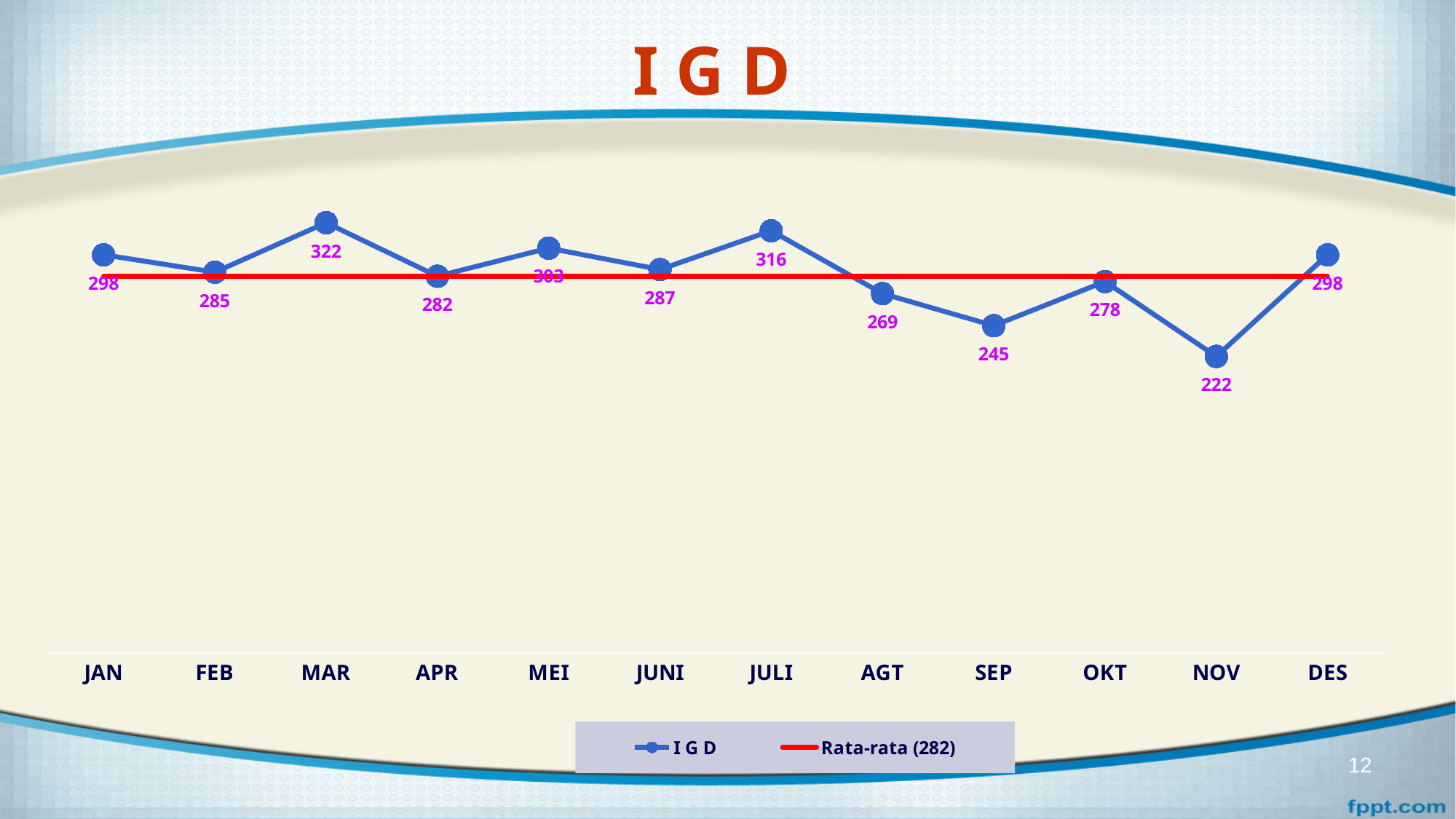
Which month has the lowest I G D value? NOV Which is larger, the I G D value for AGT or for OKT? OKT How many series does the legend list? 2 What kind of chart is shown on the slide? Line chart What is the I G D value for SEP? 245 What value does the legend give for the Rata-rata line? 282 What is the I G D value for NOV? 222 Which month has the highest I G D value? MAR What is the I G D value for MAR? 322 How many months are plotted on the x axis? 12 What is the I G D value for JULI? 316 What is the difference between the I G D values for MAR and NOV? 100